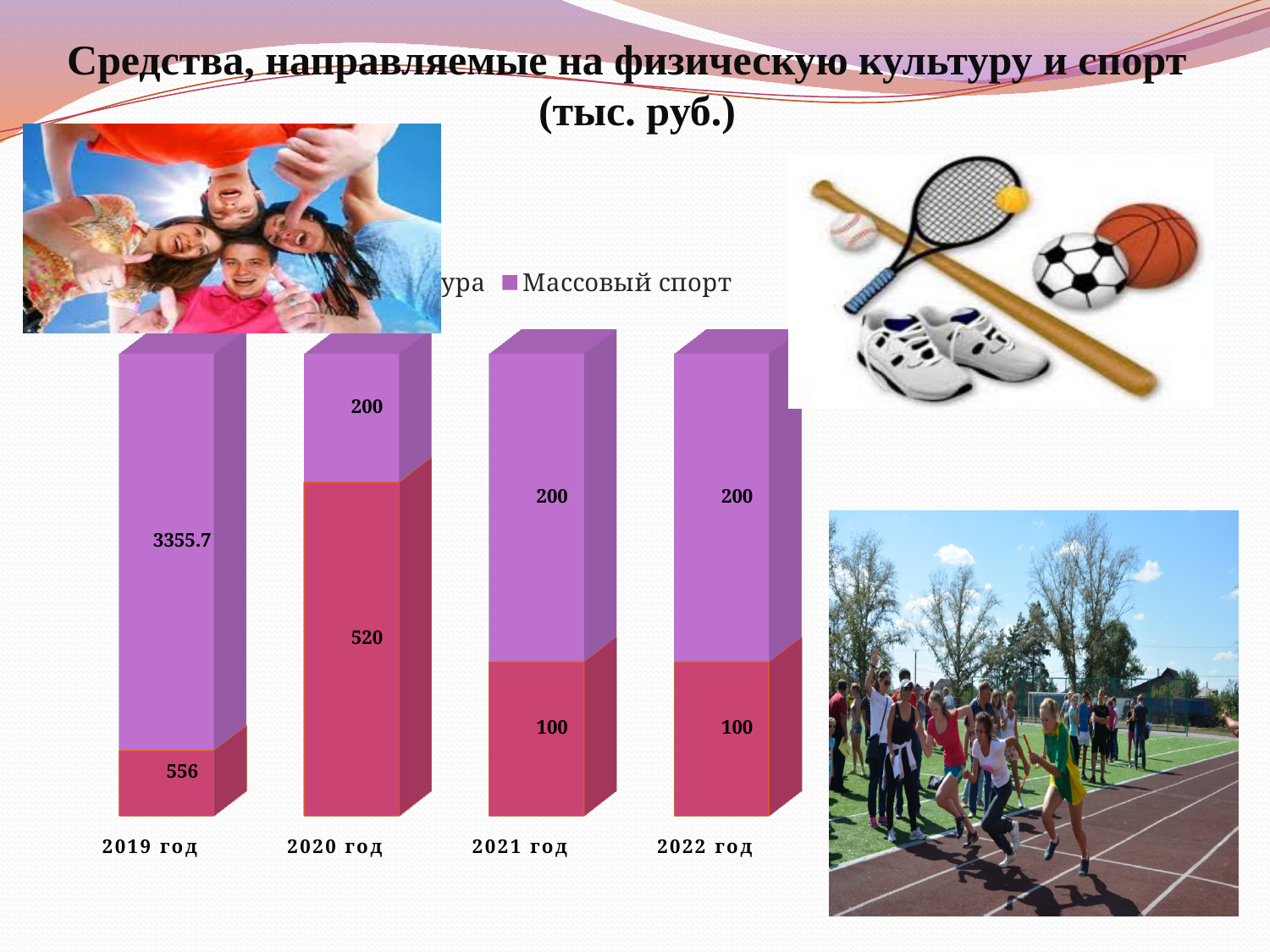
What is the value of the lower (red) segment of the bar for 2020 год? 520 What is the value of the lower (red) segment of the bar for 2022 год? 100 What is the value for Массовый спорт in 2020 год? 200 What is the total of the stacked bar for 2020 год? 720 How many series does the legend list? 2 How many years (categories) are shown on the x axis? 4 What is the value for Массовый спорт in 2019 год? 3355.7 What is the difference between the lower (red) segment values for 2020 год and 2021 год? 420 What type of chart is shown on the slide? stacked bar chart What is the value of the lower (red) segment of the bar for 2019 год? 556 What is the total of the stacked bar for 2019 год? 3911.7 In which year is the value for Массовый спорт highest? 2019 год